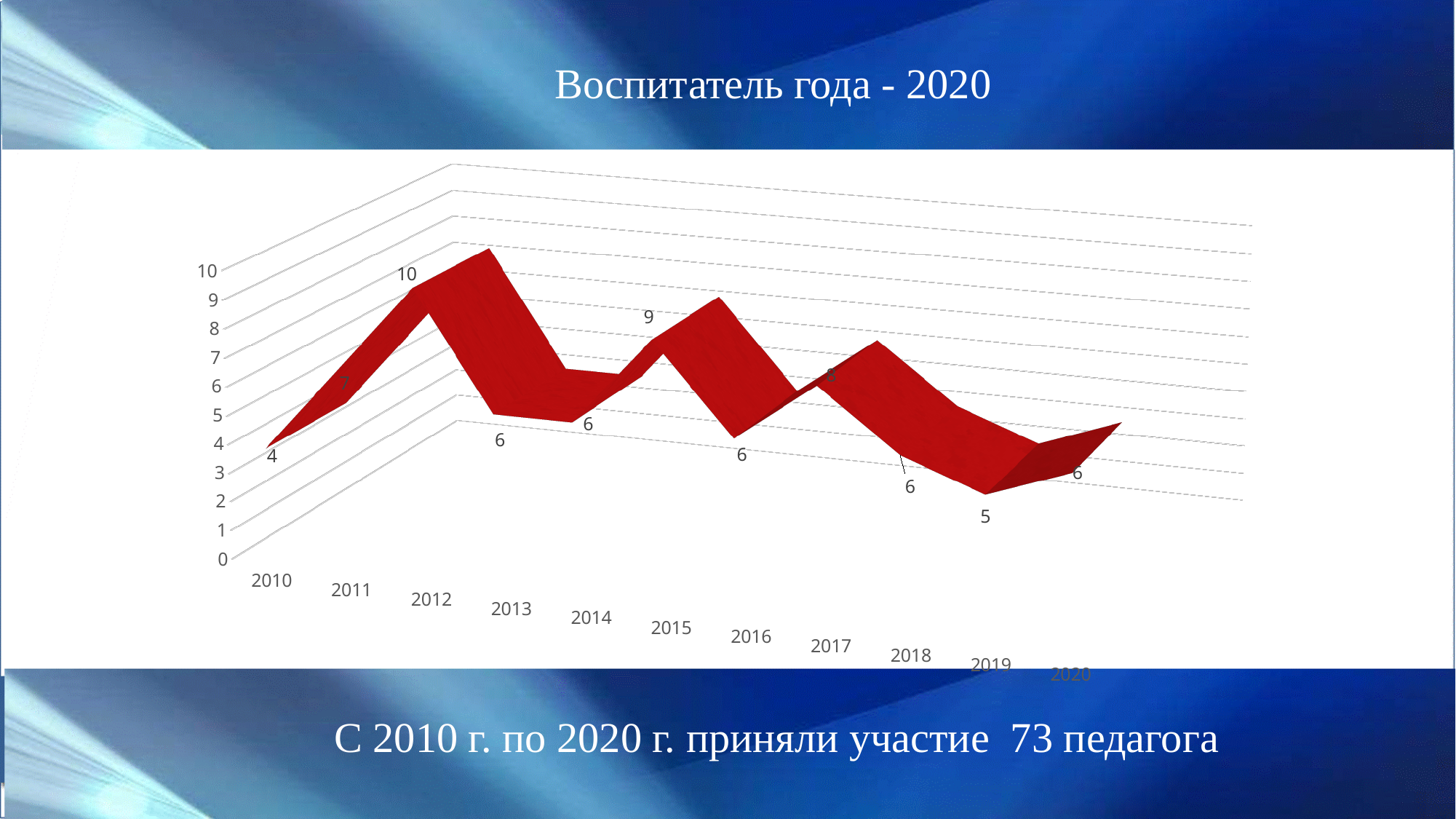
Which year has the highest value? 2012 What is the value for 2019? 5 Does the value rise or fall from 2010 to 2012? rise What kind of chart is shown on the slide? line chart What is the value for 2012? 10 Which is larger, the value for 2015 or the value for 2017? 2015 What is the value for 2010? 4 What is the value for 2017? 8 How many years are shown on the x axis? 11 Which year has the lowest value? 2010 What is the value for 2015? 9 What is the difference between the values for 2012 and 2011? 3